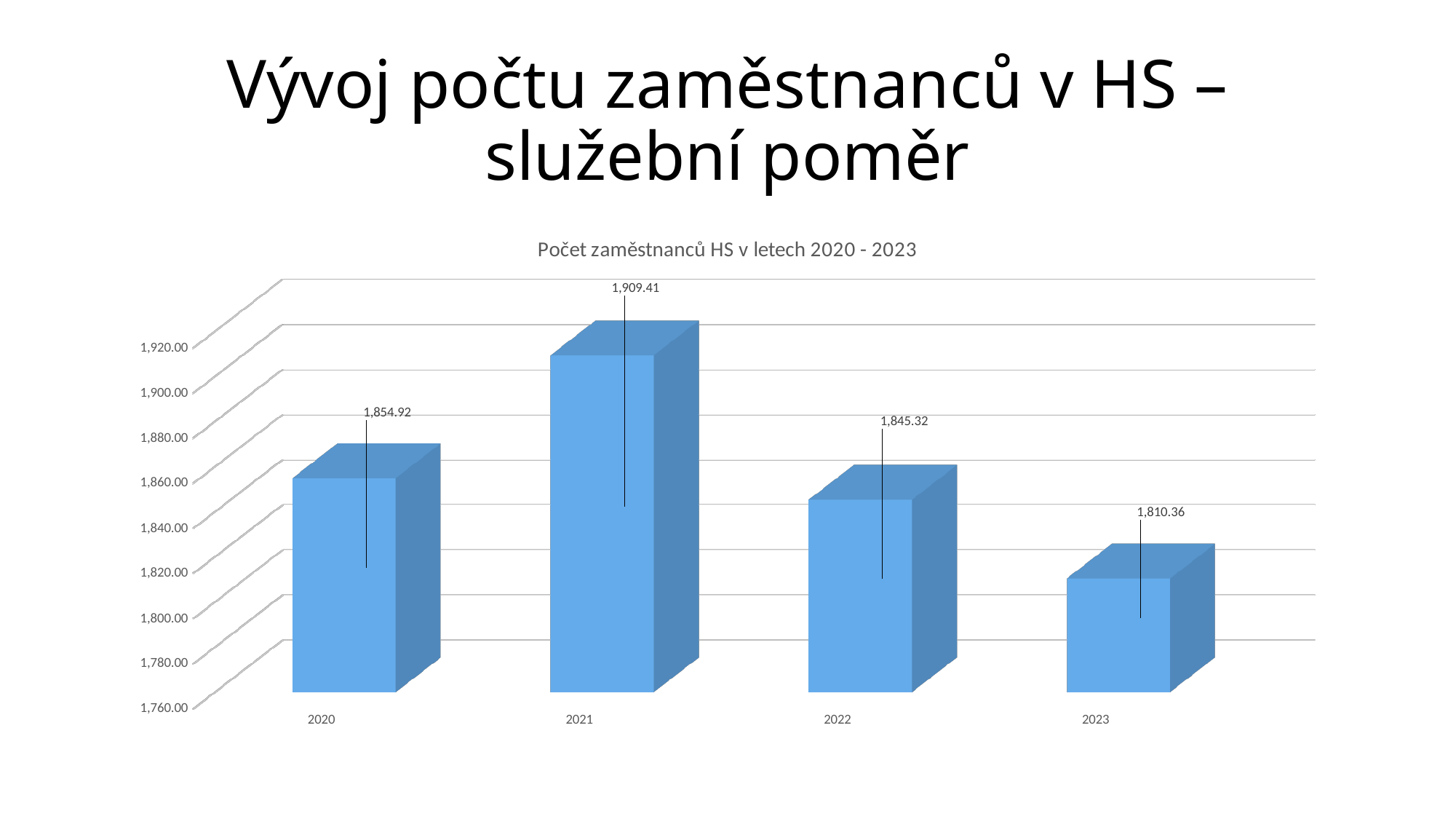
What is the value for 2023? 1,810.36 What is the value for 2021? 1,909.41 What kind of chart is shown? bar chart What is the title of the chart? Počet zaměstnanců HS v letech 2020 - 2023 How many years are shown on the x axis? 4 Which year has the highest value? 2021 What is the difference between the values for 2021 and 2020? 54.49 What is the value for 2020? 1,854.92 Which year has the lowest value? 2023 What is the difference between the values for 2022 and 2023? 34.96 Which is larger, the value for 2020 or the value for 2022? 2020 Is the value for 2023 greater or less than 1,820.00? less